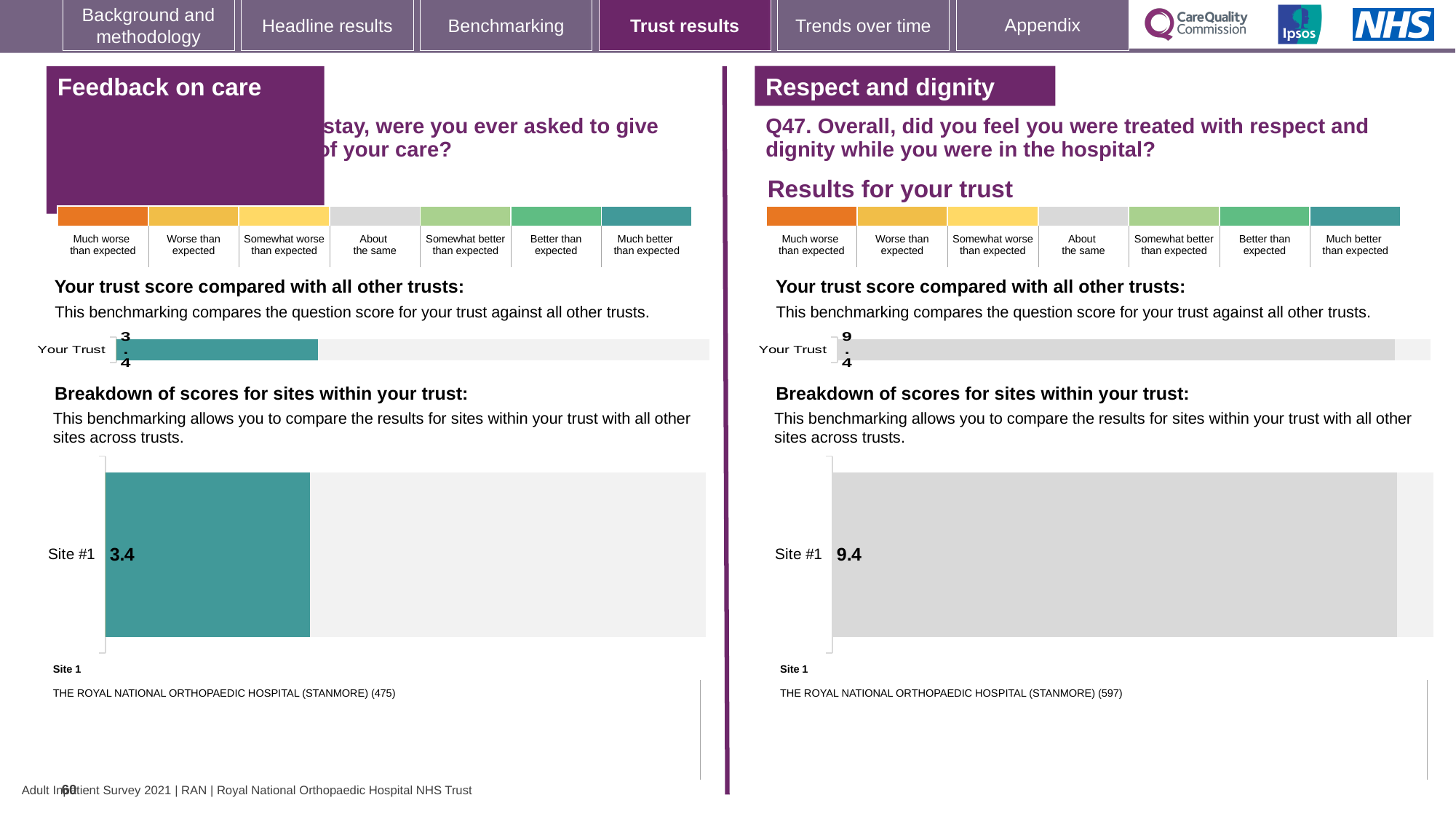
Which is larger: the Site #1 score in the 'Feedback on care' section or the Site #1 score in the 'Respect and dignity' section? Respect and dignity In the 'Respect and dignity' section, what score is shown for Site #1 in the 'Breakdown of scores for sites within your trust' chart? 9.4 Which site is listed as Site 1 in the 'Respect and dignity' section? THE ROYAL NATIONAL ORTHOPAEDIC HOSPITAL (STANMORE) (597) What type of chart is used to show the Your Trust score in the 'Respect and dignity' section? Bar chart How many sites are shown in the 'Breakdown of scores for sites within your trust' chart in the 'Respect and dignity' section? 1 In the 'Feedback on care' section, what is the score shown for Your Trust in the 'Your trust score compared with all other trusts' chart? 3.4 What is the difference between the Site #1 score in the 'Respect and dignity' section and the Site #1 score in the 'Feedback on care' section? 6.0 In the 'Respect and dignity' section, what is the score shown for Your Trust in the 'Your trust score compared with all other trusts' chart? 9.4 Which site is listed as Site 1 in the 'Feedback on care' section? THE ROYAL NATIONAL ORTHOPAEDIC HOSPITAL (STANMORE) (475) In the 'Feedback on care' section, what score is shown for Site #1 in the 'Breakdown of scores for sites within your trust' chart? 3.4 What type of chart is used to show the Site #1 score in the 'Feedback on care' section? Bar chart How many sites are shown in the 'Breakdown of scores for sites within your trust' chart in the 'Feedback on care' section? 1